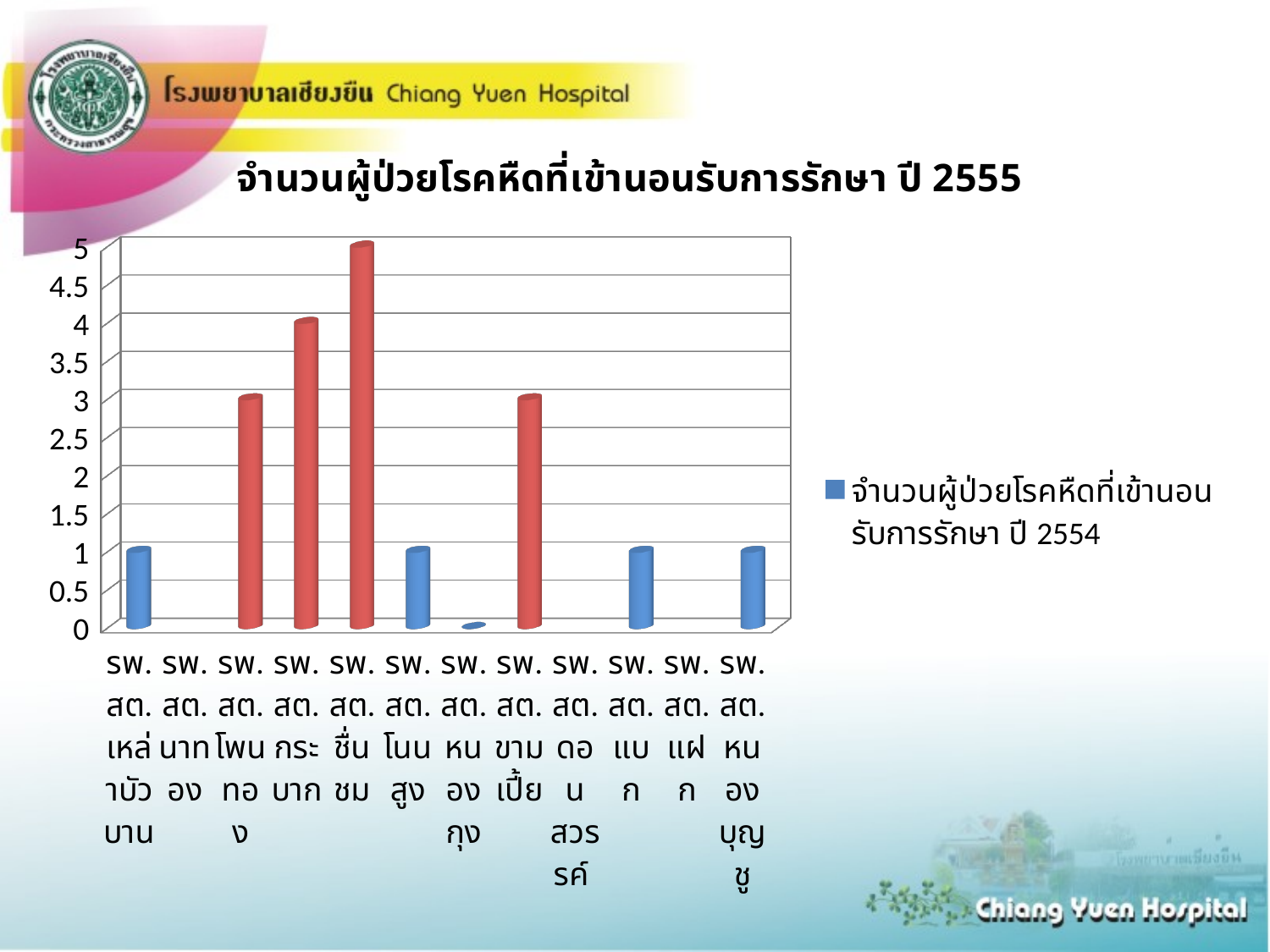
Is the value for รพ.สต.หนองกุง greater or less than 1? less What kind of chart is shown on the slide? bar chart What is the value for รพ.สต.เหล่าบัวบาน? 1 Which has a larger value, รพ.สต.กระบาก or รพ.สต.ขามเปี้ย? รพ.สต.กระบาก What is the difference between the values for รพ.สต.ชื่นชม and รพ.สต.โพนทอง? 2 What is the title of the chart? จำนวนผู้ป่วยโรคหืดที่เข้านอนรับการรักษา ปี 2555 How many categories are shown on the x axis of the chart? 12 What is the value for รพ.สต.กระบาก? 4 What is the value for รพ.สต.ชื่นชม? 5 How many series does the legend list? 1 Which category has the highest value in the chart? รพ.สต.ชื่นชม What is the value for รพ.สต.โพนทอง? 3